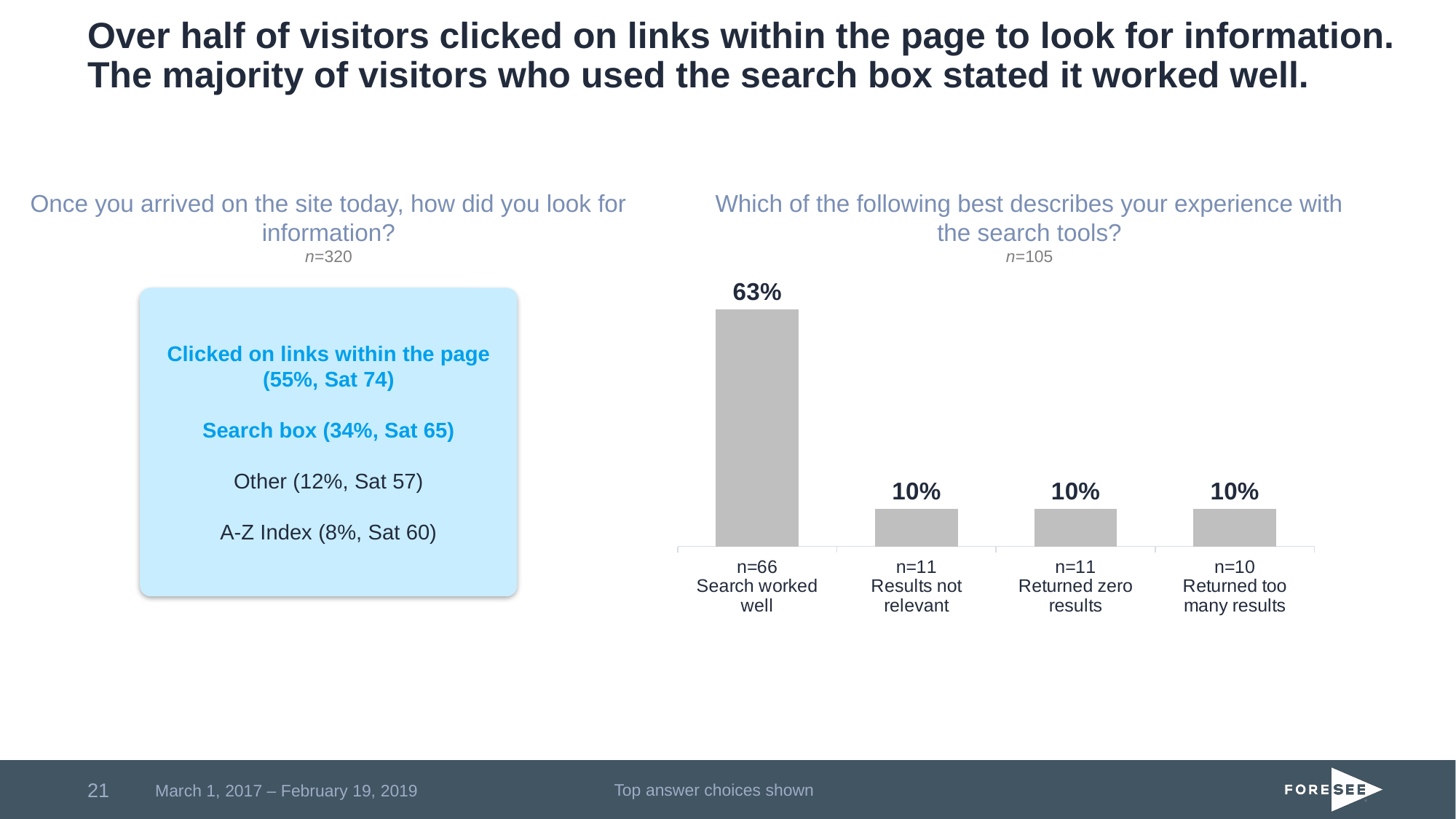
What percentage of respondents said the results were not relevant? 10% What is the n value shown for the 'Search worked well' bar? n=66 Which is larger, the percentage for 'Search worked well' or for 'Returned zero results'? Search worked well How many response categories are shown in the bar chart? 4 What percentage of respondents said the search worked well? 63% What is the n value shown for the 'Returned too many results' bar? n=10 What percentage of respondents said the search returned zero results? 10% What percentage of respondents said the search returned too many results? 10% What is the difference in percentage points between 'Search worked well' and 'Results not relevant'? 53 Which response category has the highest percentage in the chart? Search worked well What type of chart is used to show the experience with the search tools? Bar chart What is the total sample size (n) stated under the chart's title? n=105